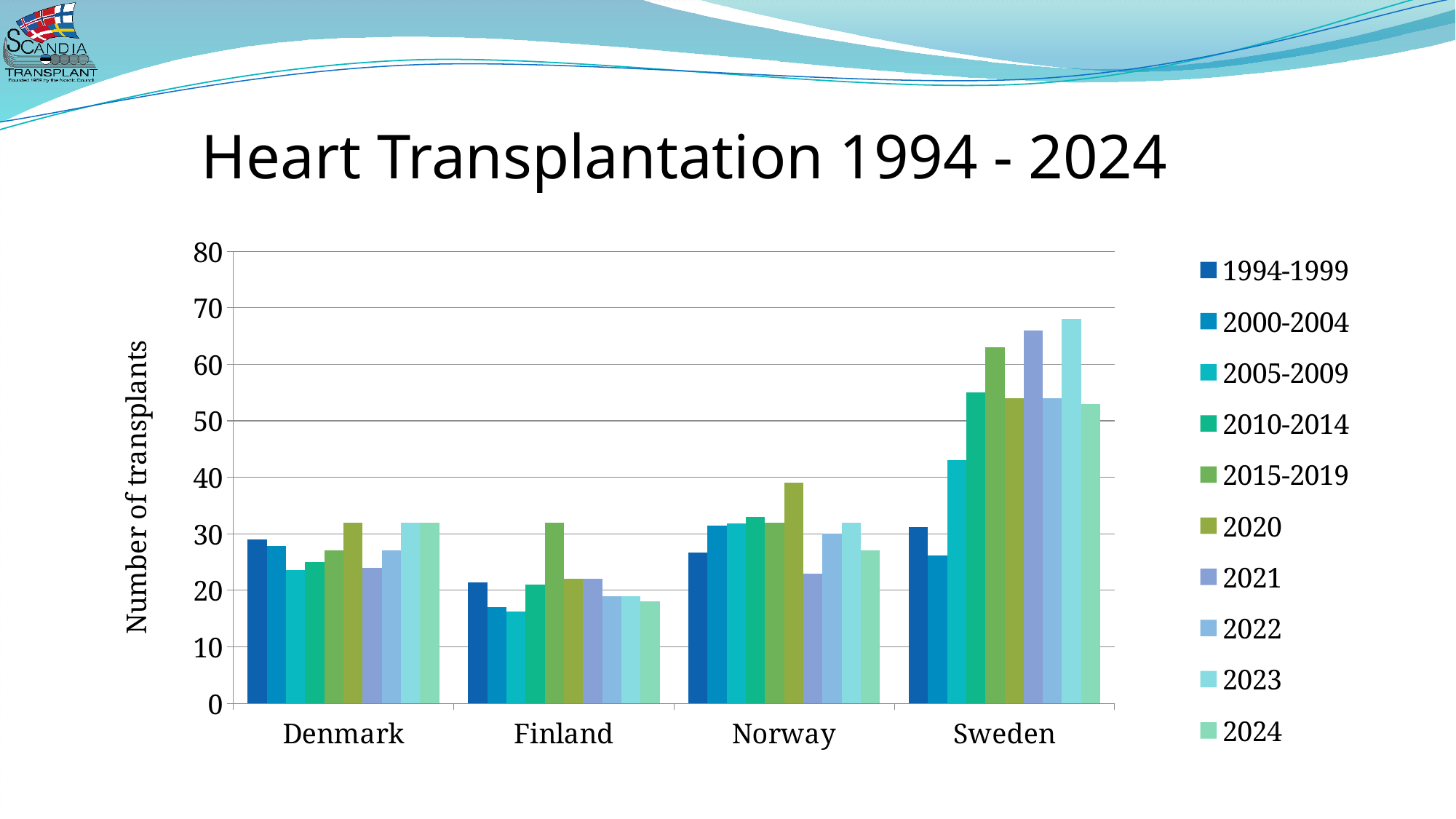
Is the value for Sweden in 2023 greater or less than 60? greater What is the label on the y axis of the chart? Number of transplants For Finland, which is larger, the 2015-2019 value or the 2020 value? 2015-2019 How many countries are shown on the x axis of the chart? 4 Which country has the highest number of transplants for 2023? Sweden How many series does the legend list? 10 Which is larger, the 2015-2019 value for Sweden or the 2015-2019 value for Denmark? Sweden Is the value for Finland in 2005-2009 greater or less than 20? less Is the value for Norway in 2020 greater or less than 30? greater Which country has the lowest number of transplants for 2024? Finland What kind of chart is shown on the slide? bar chart